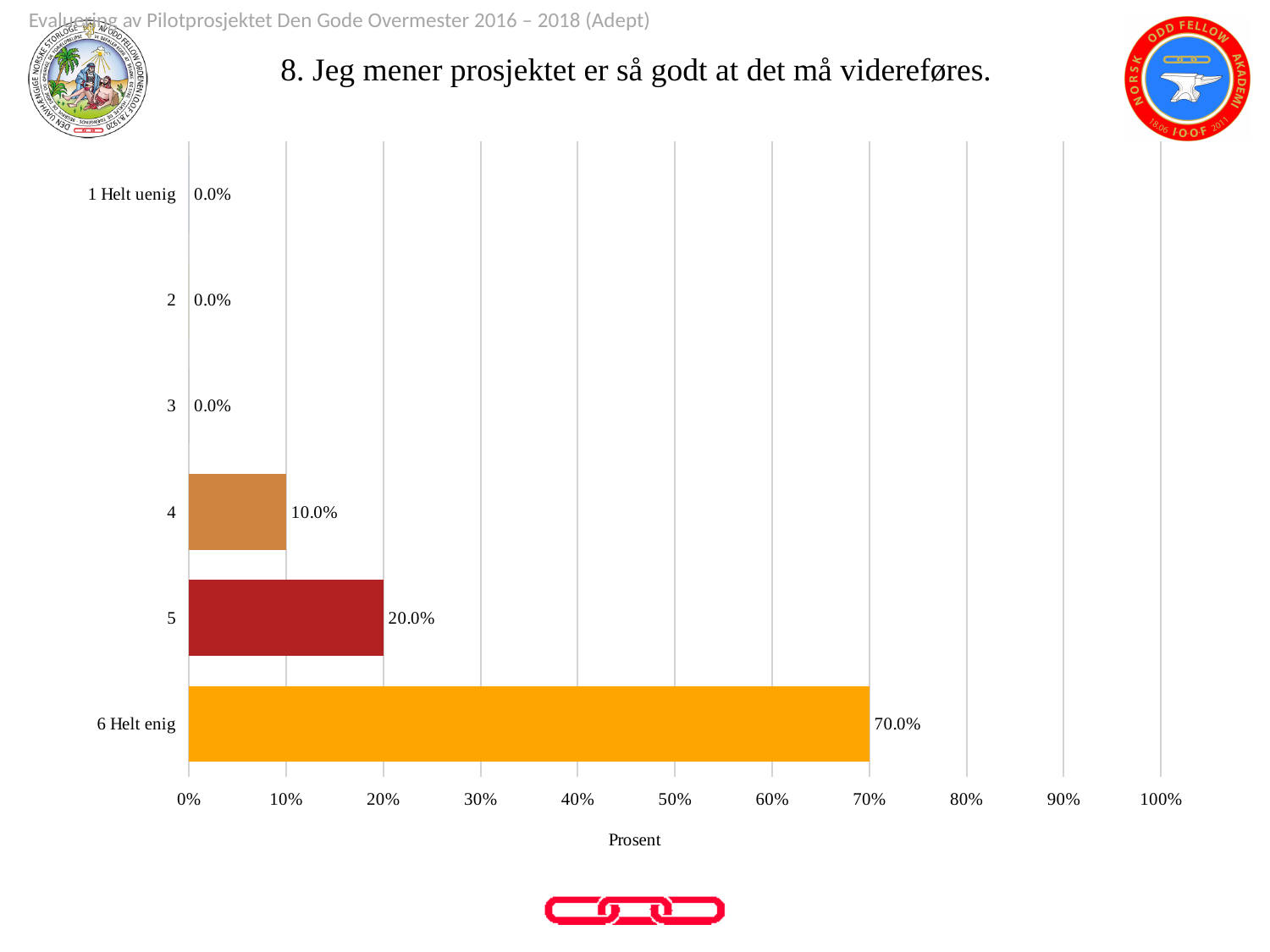
What is the value for "6 Helt enig"? 70.0% What is the label of the horizontal axis? Prosent What is the difference between the values for category 5 and category 4? 10.0% What is the value for category 5? 20.0% What is the difference between the values for "6 Helt enig" and category 5? 50.0% What is the value for "1 Helt uenig"? 0.0% Is the value for "6 Helt enig" greater or less than 50%? greater Which category has the highest value? 6 Helt enig How many categories are shown on the chart? 6 What is the value for category 4? 10.0% Which is larger, the value for category 4 or the value for category 5? 5 What kind of chart is shown on the slide? bar chart